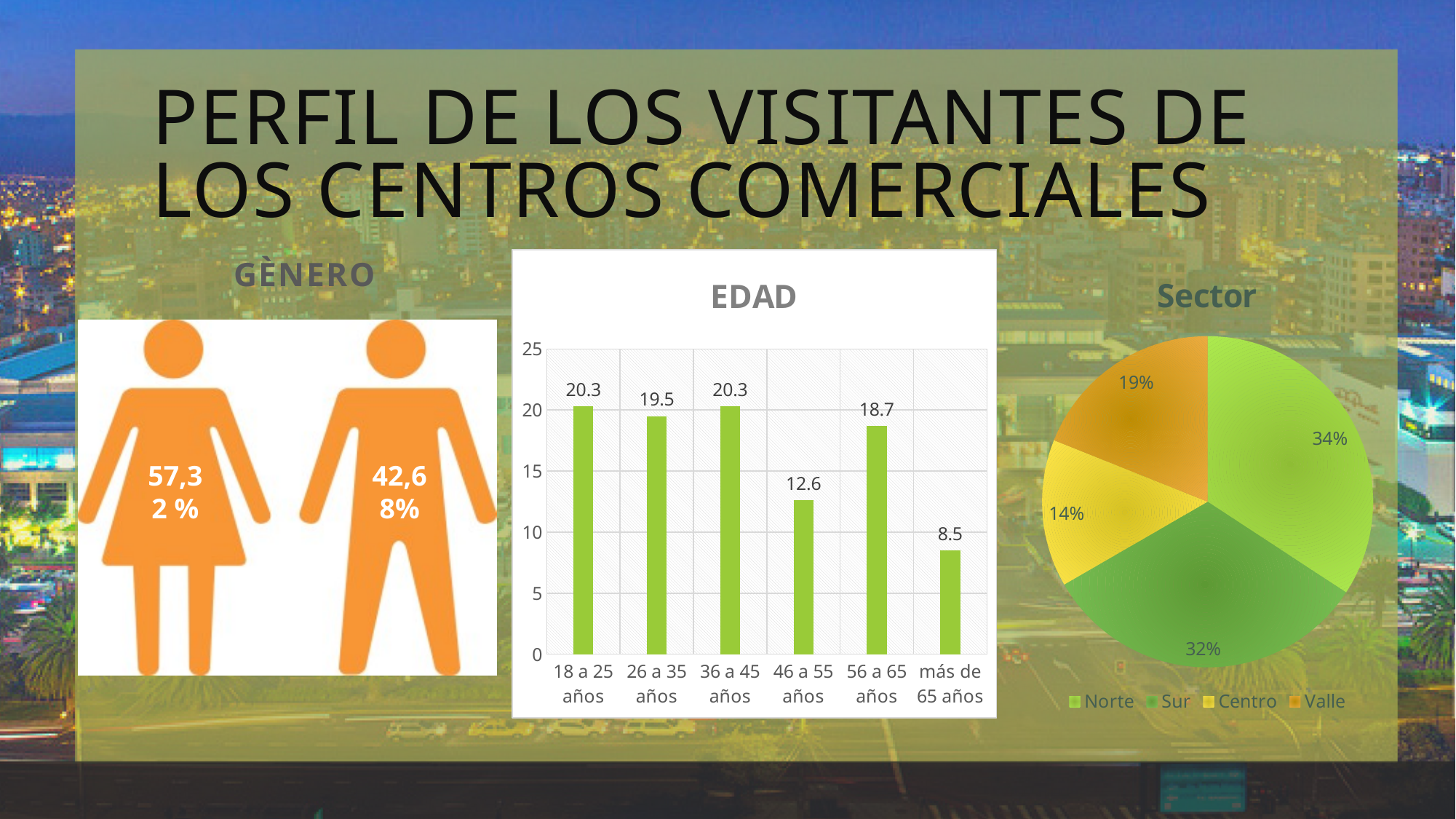
How many entries does the legend of the Sector pie chart list? 4 In the EDAD chart, what is the value for the 46 a 55 años group? 12.6 In the Sector pie chart, which sector has the smallest share? Centro In the EDAD chart, what is the value for the 56 a 65 años group? 18.7 In the EDAD chart, how many age groups are shown? 6 In the Sector pie chart, what is the difference between the shares of Sur and Valle? 13% What kind of chart is the EDAD chart? bar chart In the Sector pie chart, which sector is shown in orange? Valle In the EDAD chart, which age group has the lowest value? más de 65 años In the EDAD chart, which is larger: the value for 26 a 35 años or the value for 46 a 55 años? 26 a 35 años In the Sector pie chart, what share does Norte have? 34% In the EDAD chart, what is the difference between the values for 26 a 35 años and más de 65 años? 11